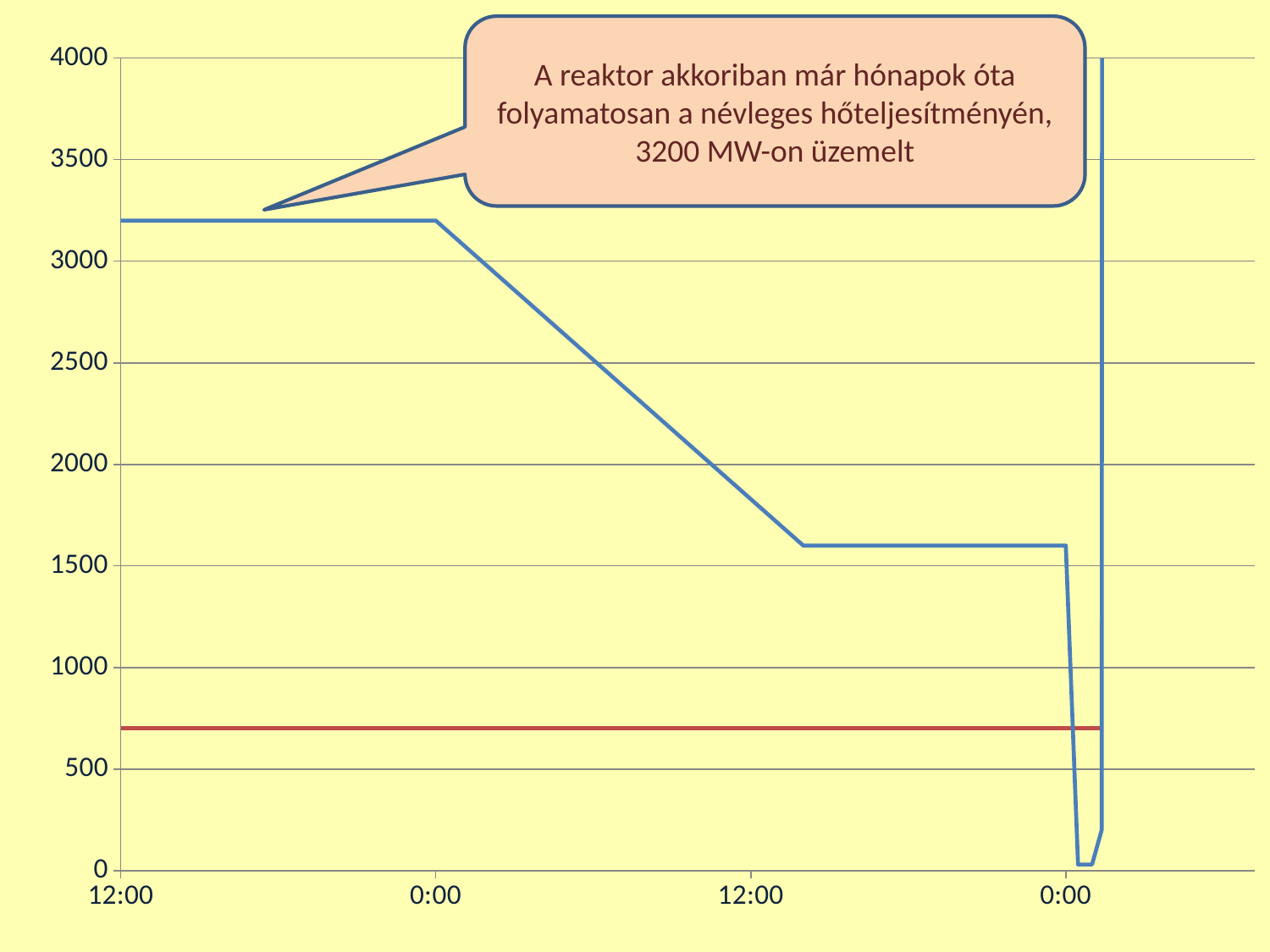
What kind of chart is shown on the slide? line chart What is the highest value shown on the y axis? 4000 How many time labels are shown on the x axis? 4 Does the blue line rise or fall between the first 0:00 and the second 12:00 on the x axis? fall Is the value of the blue line's lower plateau (between the second 12:00 and the last 0:00) greater or less than 2000? less According to the callout, at what thermal power had the reactor been operating continuously for months? 3200 MW Is the value of the red horizontal line greater or less than 1000? less Is the value of the red horizontal line greater or less than 500? greater What colour is the horizontal line that stays constant across the whole chart? red Which is larger at the start of the chart: the blue line or the red line? the blue line